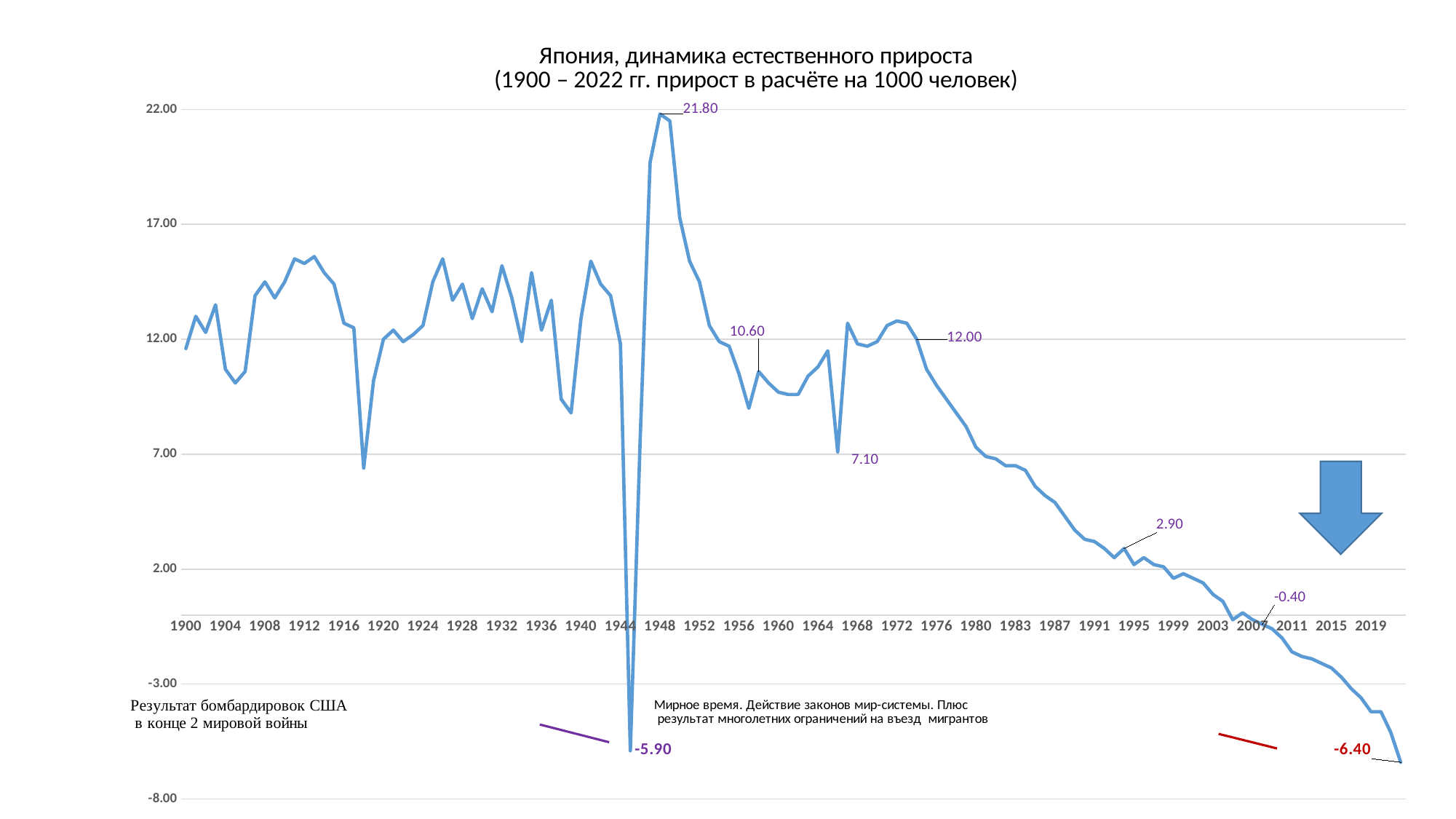
What is the highest value labelled on the chart? 21.80 What is the difference between the labelled peak value 21.80 and the labelled dip value -5.90? 27.70 What value is labelled at the dip between 1964 and 1968? 7.10 Which labelled value is larger, 10.60 or 12.00? 12.00 What value is labelled near 1995? 2.90 Does the line rise or fall from 1972 to 2022? fall What kind of chart is shown on the slide? line chart What is the lowest value labelled on the chart? -6.40 What value is labelled at the sharp dip in the mid-1940s? -5.90 What value is labelled near 2007? -0.40 Is the value for 1987 greater or less than 7.00? less What is the difference between the labelled values 12.00 and 7.10? 4.90